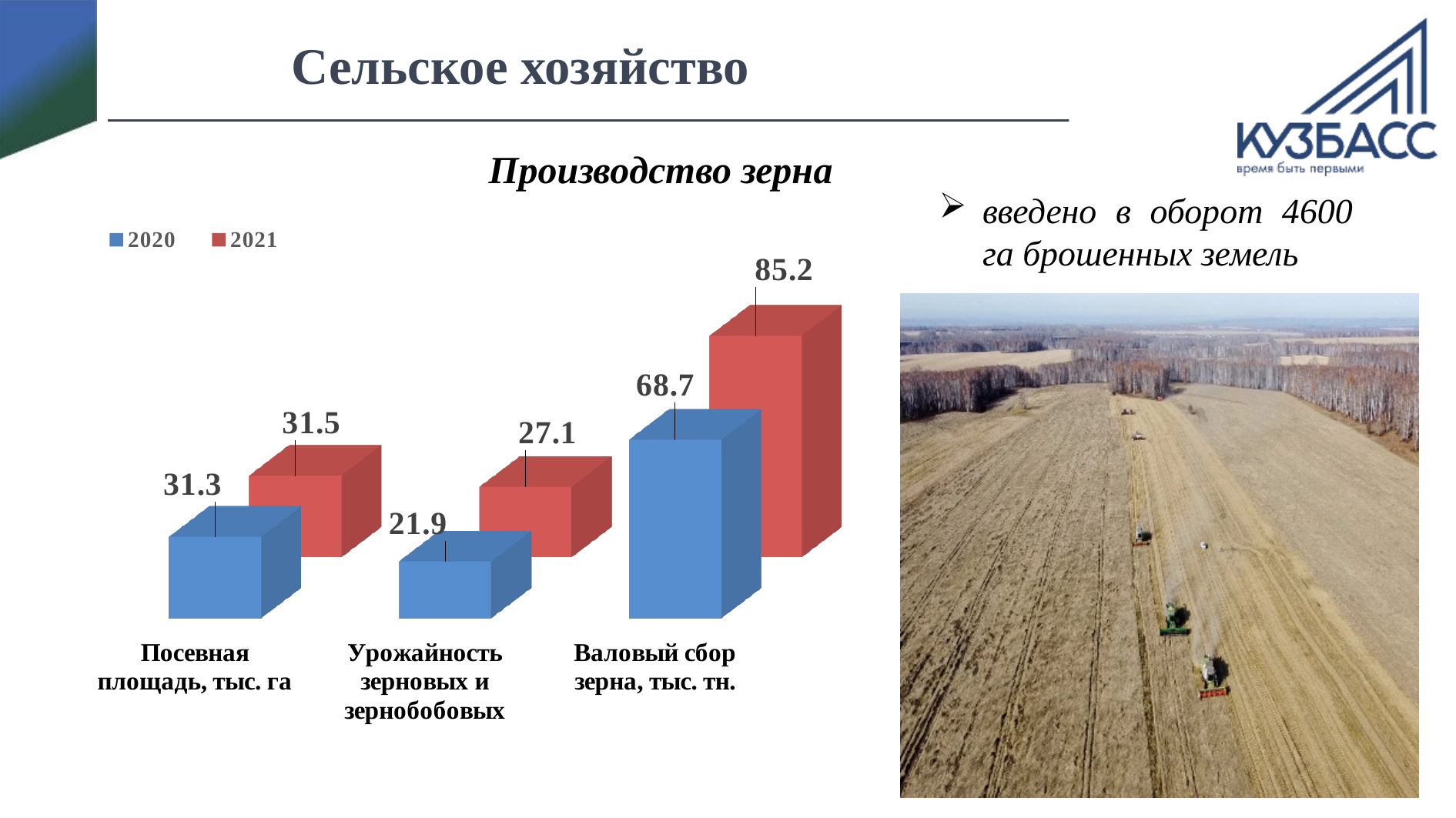
What is the 2021 value for Урожайность зерновых и зернобобовых? 27.1 What is the difference between the 2021 and 2020 values for Урожайность зерновых и зернобобовых? 5.2 Which category has the lowest 2020 value? Урожайность зерновых и зернобобовых What is the 2020 value for Урожайность зерновых и зернобобовых? 21.9 What is the 2020 value for Посевная площадь, тыс. га? 31.3 What is the title of the chart? Производство зерна What is the difference between the 2021 and 2020 values for Валовый сбор зерна, тыс. тн.? 16.5 What is the 2021 value for Валовый сбор зерна, тыс. тн.? 85.2 Which category has the highest 2021 value? Валовый сбор зерна, тыс. тн. How many series does the legend list? 2 Which is larger: the 2020 value for Валовый сбор зерна or the 2021 value for Посевная площадь? 2020 value for Валовый сбор зерна How many categories are shown on the x axis? 3